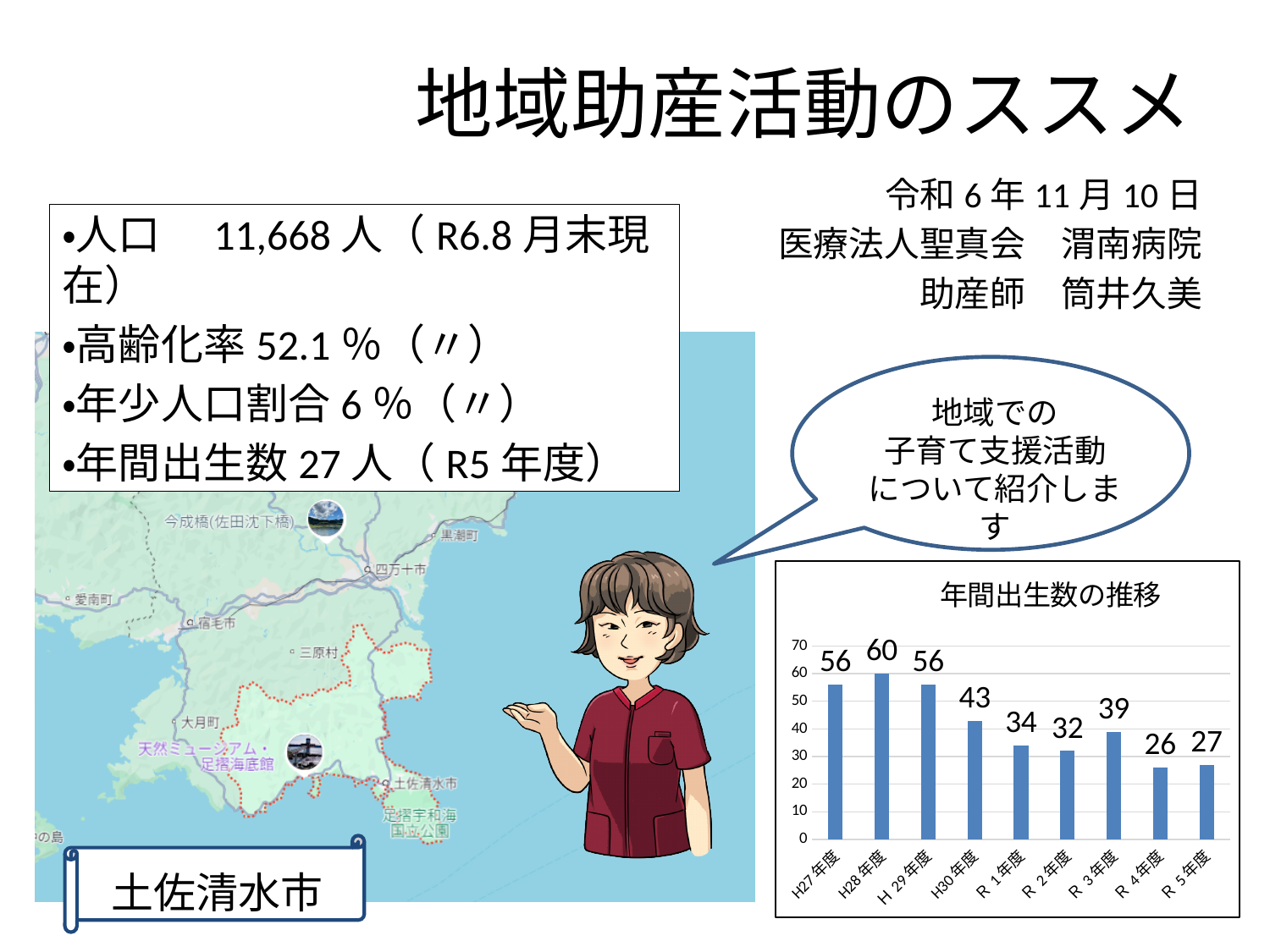
What is the value for H28年度 in the chart? 60 What is the difference between the values for H28年度 and R4年度? 34 How many fiscal years (categories) are plotted in the chart? 9 Which fiscal year has the highest value in the chart? H28年度 What is the title of the chart on the slide? 年間出生数の推移 What is the value for R5年度 in the chart? 27 What kind of chart is shown on the slide? bar chart Overall, do the values rise or fall from H27年度 to R5年度? fall Is the value for R1年度 greater or less than 40? less What is the value for H30年度 in the chart? 43 Which is larger, the value for R3年度 or the value for R2年度? R3年度 Which fiscal year has the lowest value in the chart? R4年度